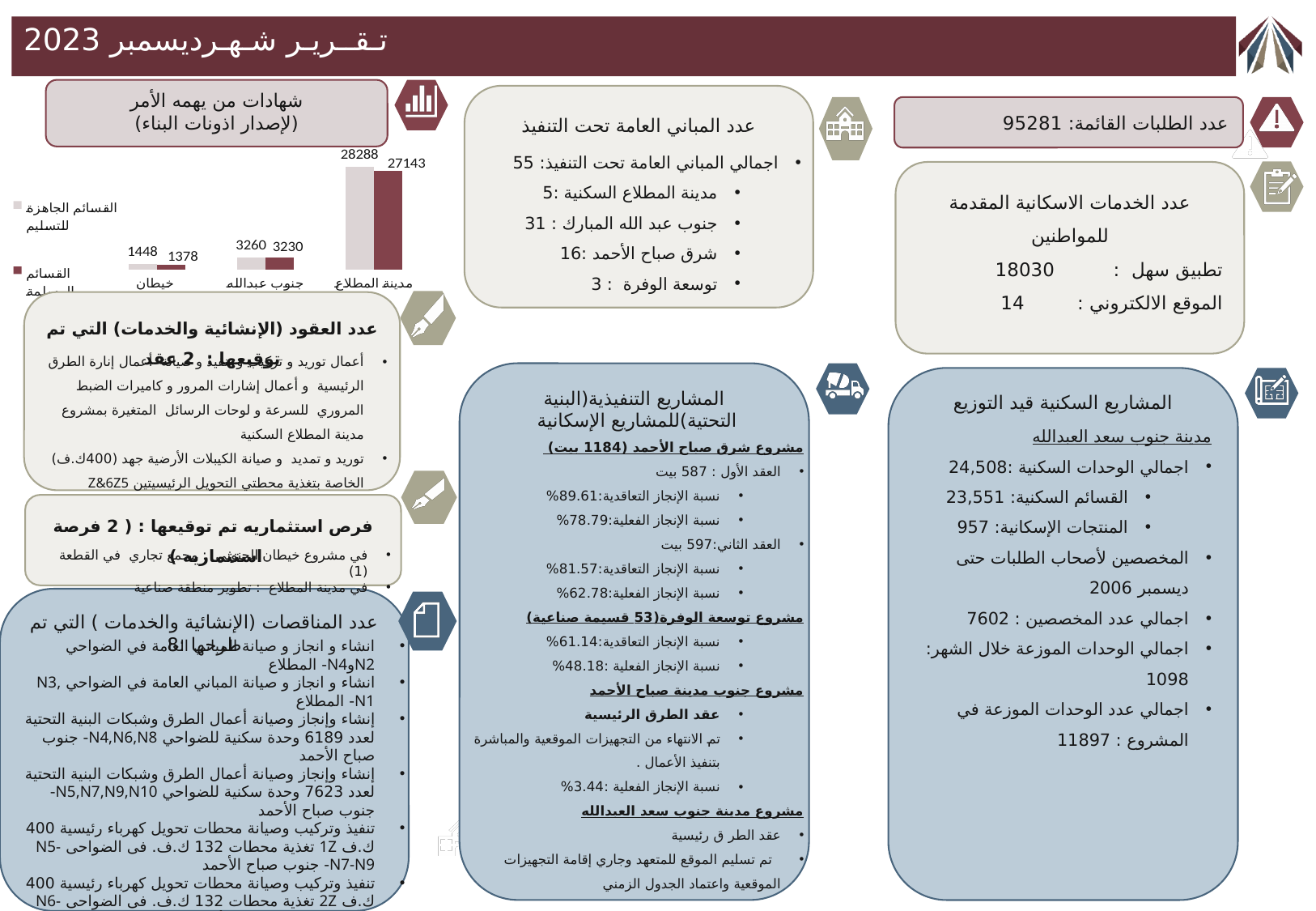
In the bar chart, what is the value of القسائم الجاهزة للتسليم for مدينة المطلاع? 28288 How many categories are shown on the x axis of the bar chart? 3 Which category has the lowest value for القسائم الجاهزة للتسليم in the bar chart? خيطان What kind of chart is shown on the slide under the heading شهادات من يهمه الأمر? Bar chart In the bar chart, what is the value of the darker (second) series for مدينة المطلاع? 27143 Which category has the highest value for القسائم الجاهزة للتسليم in the bar chart? مدينة المطلاع In the bar chart, which is larger for القسائم الجاهزة للتسليم: خيطان or جنوب عبدالله? جنوب عبدالله In the bar chart, what is the difference between the two series values for مدينة المطلاع (28288 and 27143)? 1145 In the bar chart, what is the value of the darker (second) series for خيطان? 1378 In the bar chart, what is the value of القسائم الجاهزة للتسليم for خيطان? 1448 How many series does the legend of the bar chart list? 2 In the bar chart, what is the value of القسائم الجاهزة للتسليم for جنوب عبدالله? 3260